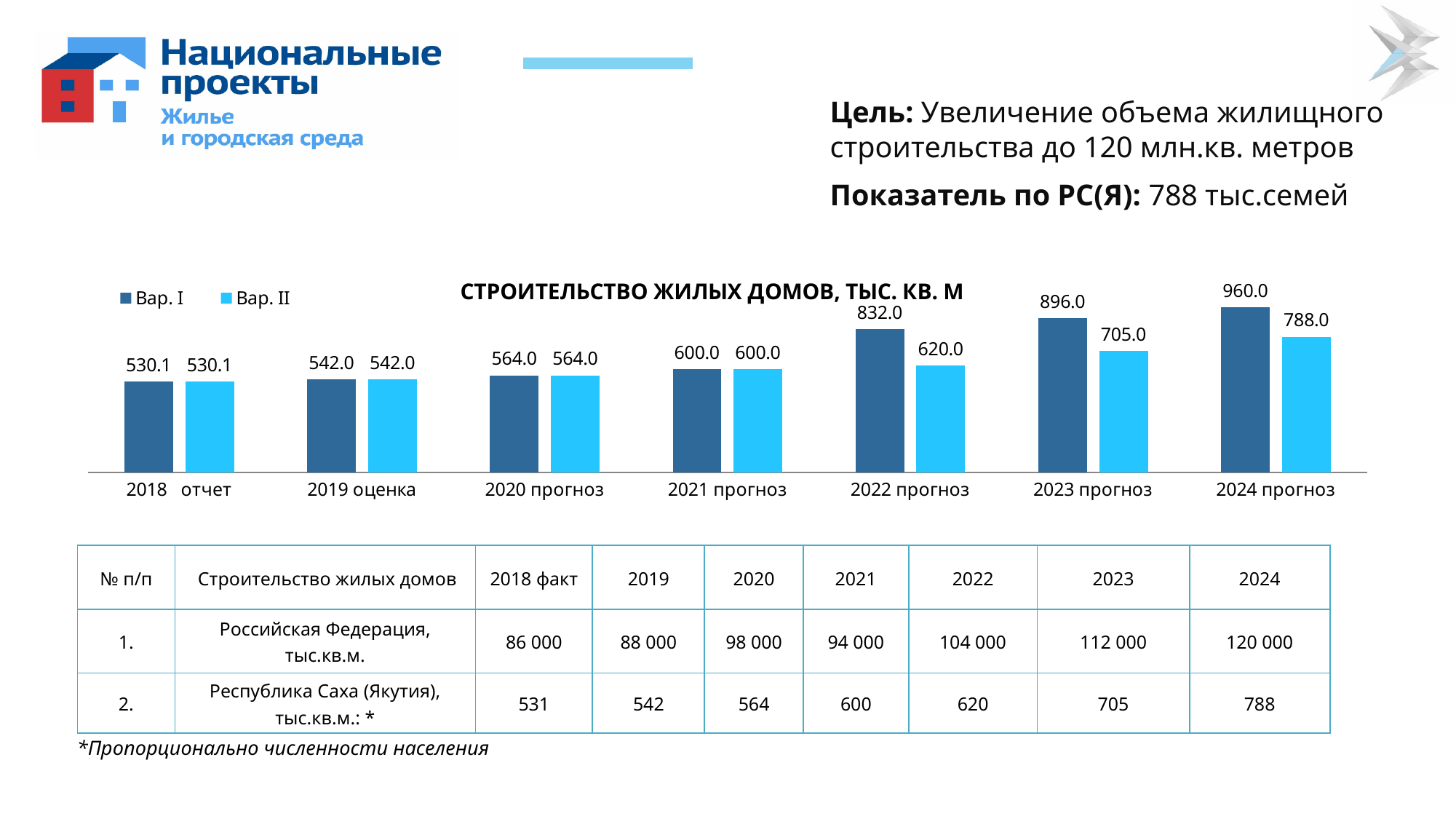
Do the Вар. II values rise or fall from 2018 отчет to 2024 прогноз? rise What is the value of Вар. I for 2018 отчет? 530.1 What is the difference between Вар. I and Вар. II for 2022 прогноз? 212.0 Which category has the highest value for Вар. I? 2024 прогноз What is the title of the chart? СТРОИТЕЛЬСТВО ЖИЛЫХ ДОМОВ, ТЫС. КВ. М How many series does the chart legend list? 2 Which is larger for 2023 прогноз: Вар. I or Вар. II? Вар. I Which category has the lowest value for Вар. II? 2018 отчет What type of chart is shown on the slide? bar chart What is the value of Вар. II for 2023 прогноз? 705.0 What is the value of Вар. I for 2024 прогноз? 960.0 How many categories are shown on the x axis of the chart? 7